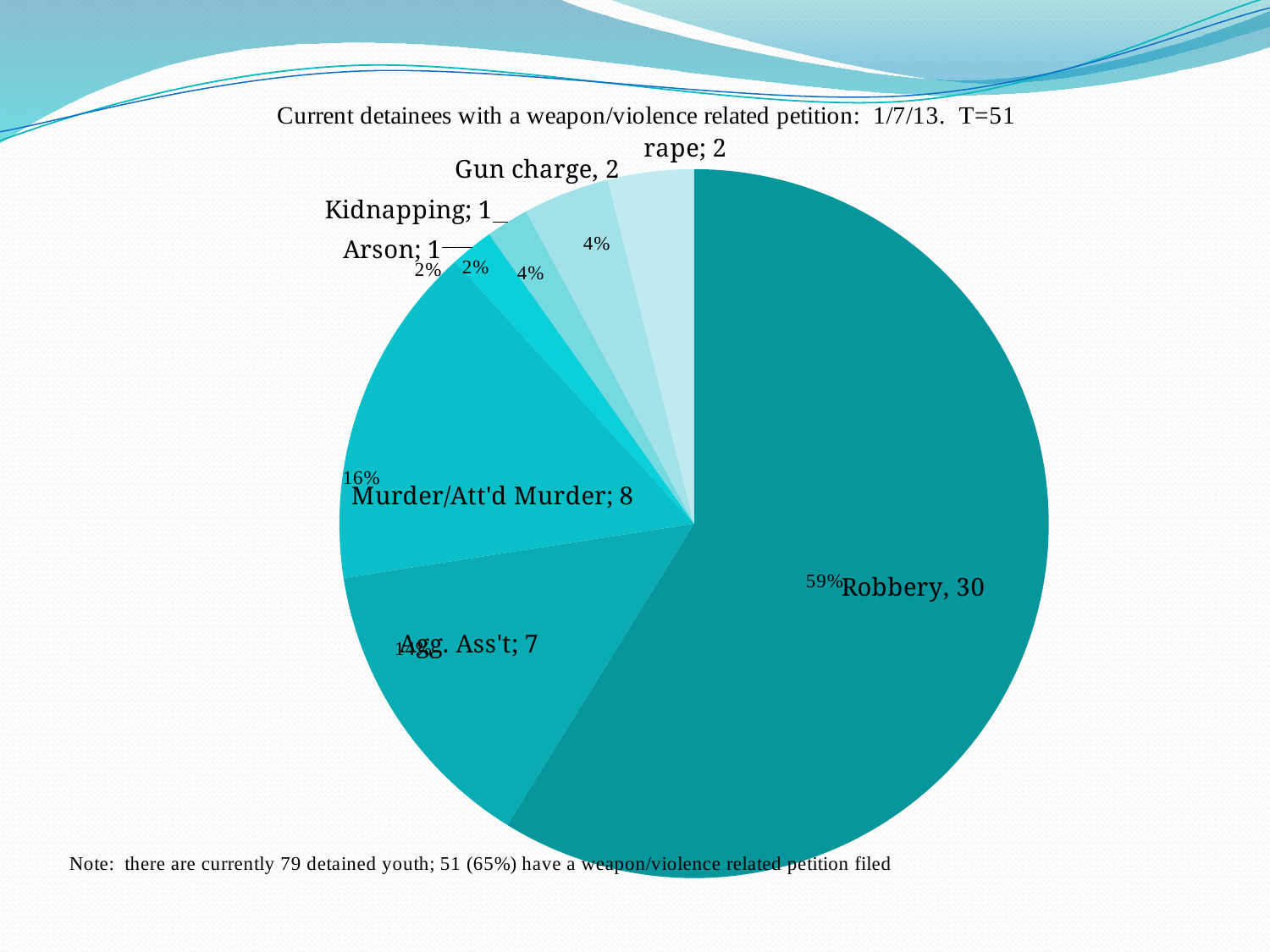
Which category has the largest slice of the pie? Robbery What is the value for Agg. Ass't? 7 What kind of chart is shown on the slide? pie chart What share of the pie does Murder/Att'd Murder represent? 16% What share of the pie does Robbery represent? 59% How many detainees have a Robbery petition? 30 What is the difference between the value for Robbery and the value for Murder/Att'd Murder? 22 What is the value for Gun charge? 2 What is the title of the chart? Current detainees with a weapon/violence related petition: 1/7/13. T=51 What is the value for Kidnapping? 1 Which is larger, the value for Murder/Att'd Murder or the value for Agg. Ass't? Murder/Att'd Murder What is the value for Murder/Att'd Murder? 8